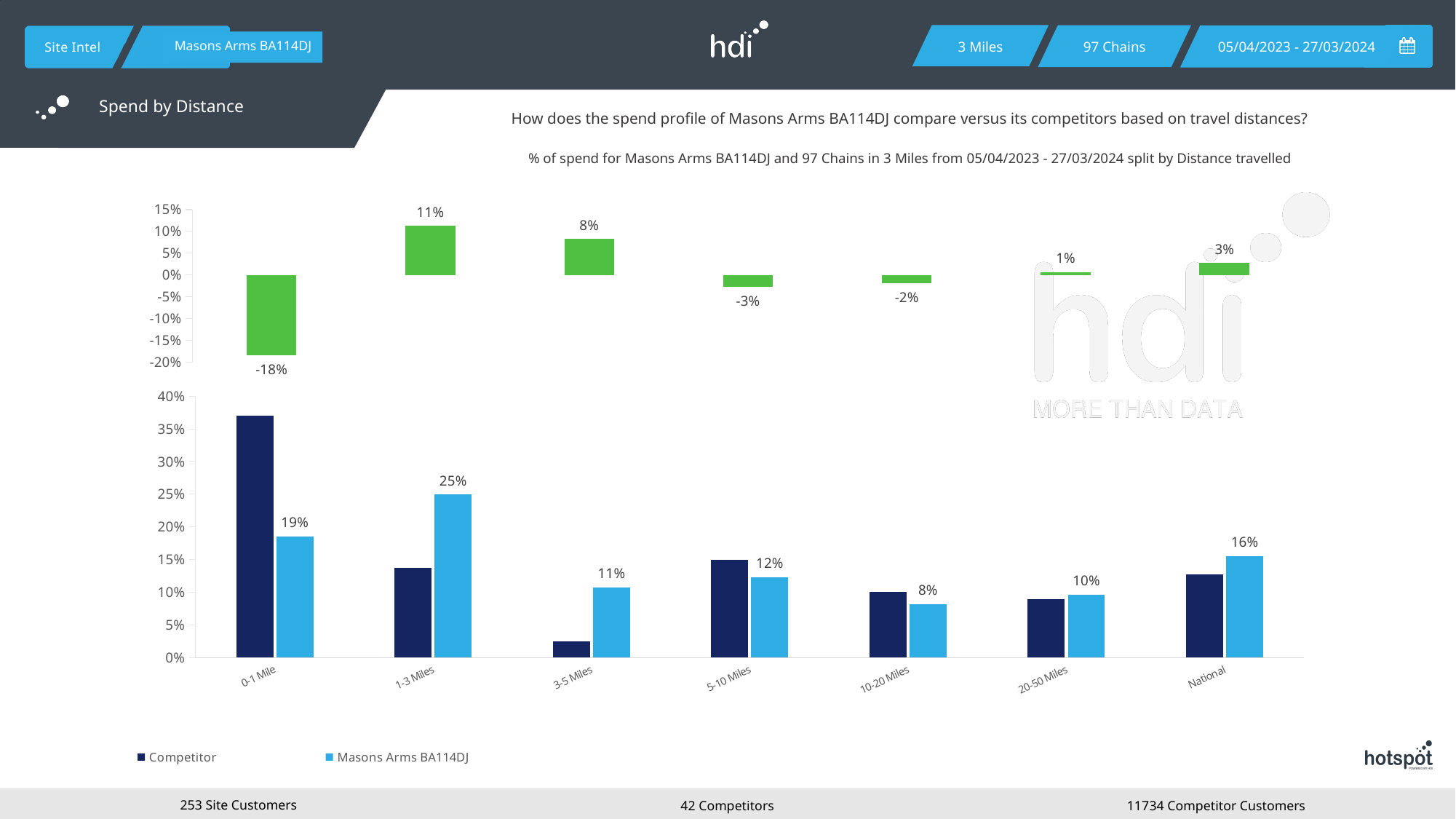
On the top green chart, what is the value of the first (leftmost) bar? -18% On the bottom chart, which category has the lowest Masons Arms BA114DJ value? 10-20 Miles On the bottom chart, is the Competitor value for 0-1 Mile greater or less than 35%? greater On the bottom chart, what is the value for Masons Arms BA114DJ in the 1-3 Miles category? 25% What kind of chart is the bottom chart? bar chart On the bottom chart, in the 0-1 Mile category, which series has the larger value: Competitor or Masons Arms BA114DJ? Competitor On the bottom chart, what is the value for Masons Arms BA114DJ in the National category? 16% On the bottom chart, how many distance categories are shown on the x axis? 7 On the bottom chart, what is the difference between the Masons Arms BA114DJ values for 1-3 Miles and 0-1 Mile? 6 percentage points On the bottom chart, how many series does the legend list? 2 On the bottom chart, is the Competitor value for 3-5 Miles greater or less than 5%? less On the bottom chart, which category has the highest Masons Arms BA114DJ value? 1-3 Miles